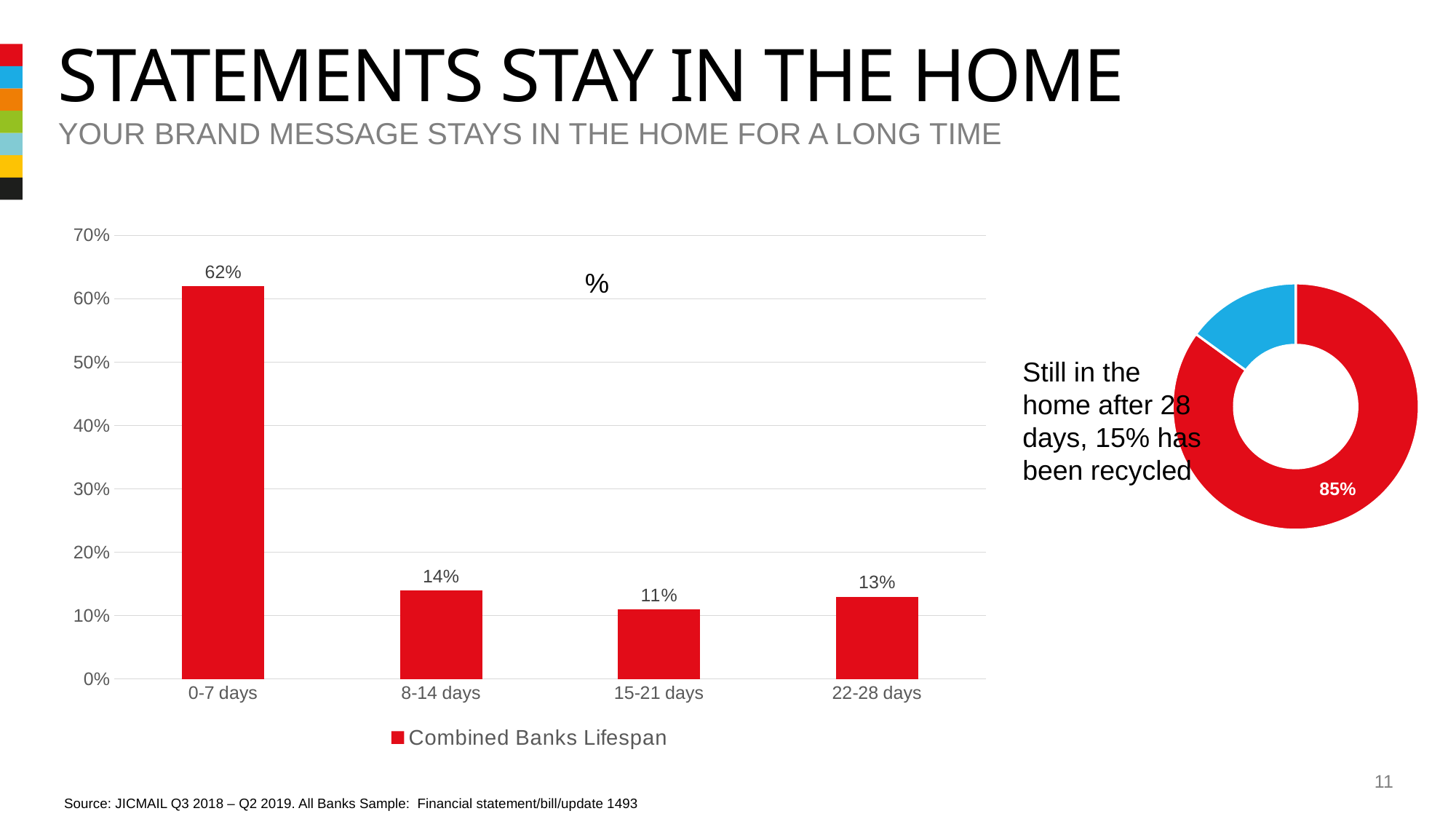
In the bar chart, which category has the highest value? 0-7 days In the bar chart, what is the difference between the values for 0-7 days and 8-14 days? 48% In the bar chart, which is larger, the value for 8-14 days or the value for 22-28 days? 8-14 days How many categories are shown on the x axis of the bar chart? 4 In the doughnut chart on the right, what share is shown by the red slice? 85% In the bar chart, which category has the lowest value? 15-21 days What is the name of the series in the bar chart's legend? Combined Banks Lifespan In the bar chart, what is the value for 22-28 days? 13% In the bar chart, what is the value for 15-21 days? 11% What kind of chart is the chart on the left of the slide? bar chart In the bar chart, what is the value for 0-7 days? 62% How many series does the legend of the bar chart list? 1